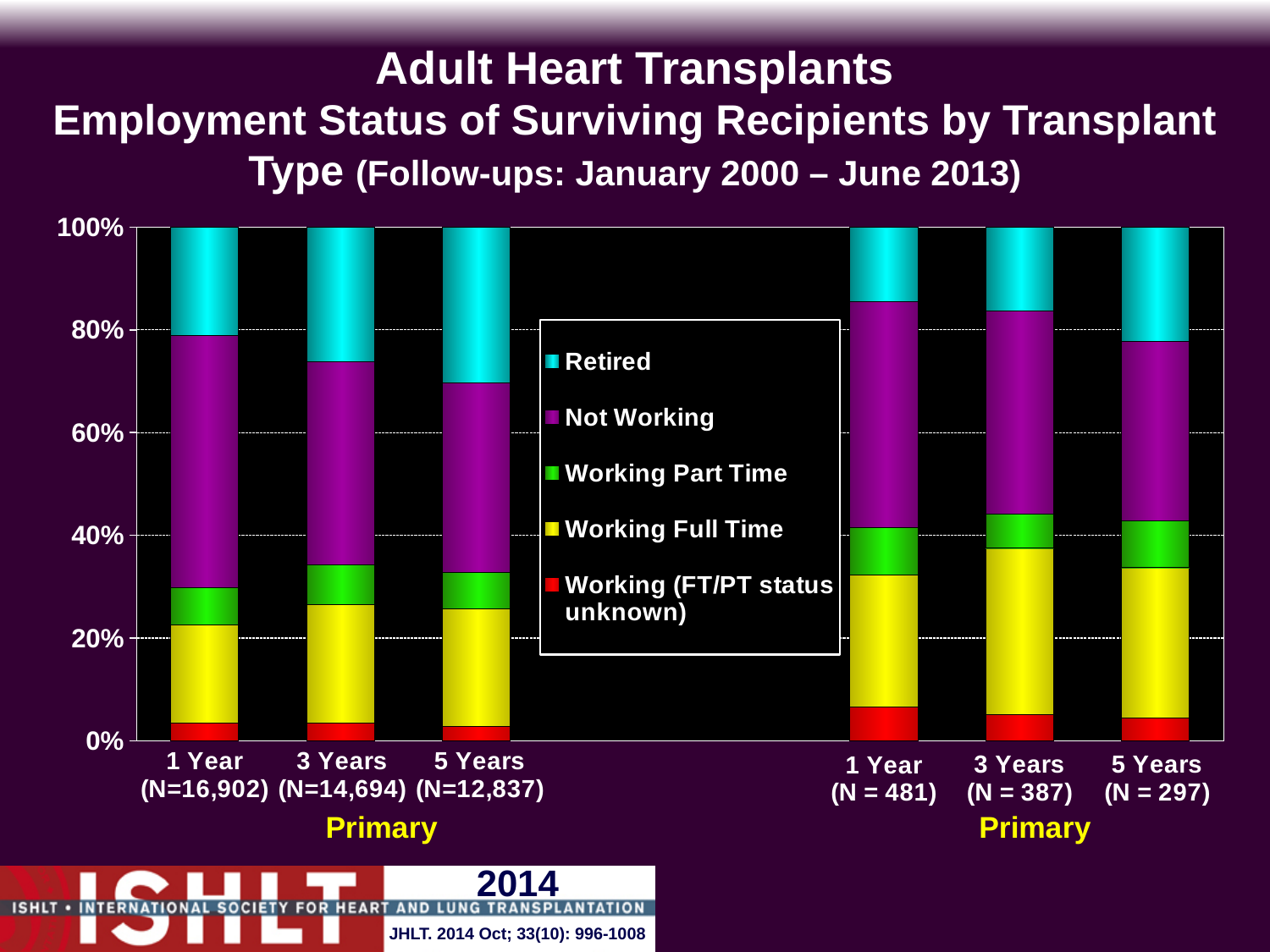
Which bar has the larger Retired segment: 1 Year (N=16,902) or 5 Years (N=12,837)? 5 Years (N=12,837) What is the sample size (N) for the 5 Years bar in the right group? 297 How many bars are plotted in the chart? 6 Does the top of the Not Working segment for the 1 Year (N = 481) bar lie above or below the 80% gridline? above Which legend entry is shown in cyan at the top of each bar? Retired Does the top of the Not Working segment for the 1 Year (N=16,902) bar lie above or below the 60% gridline? above What is the sample size (N) for the 1 Year bar in the left group? 16,902 What is the sample size (N) for the 3 Years bar in the left group? 14,694 What kind of chart is shown on the slide? Stacked bar chart How many series does the legend list? 5 Does the top of the Working Full Time segment for the 1 Year (N=16,902) bar lie above or below the 40% gridline? below In the left group, does the Retired share rise or fall from 1 Year to 5 Years? rises